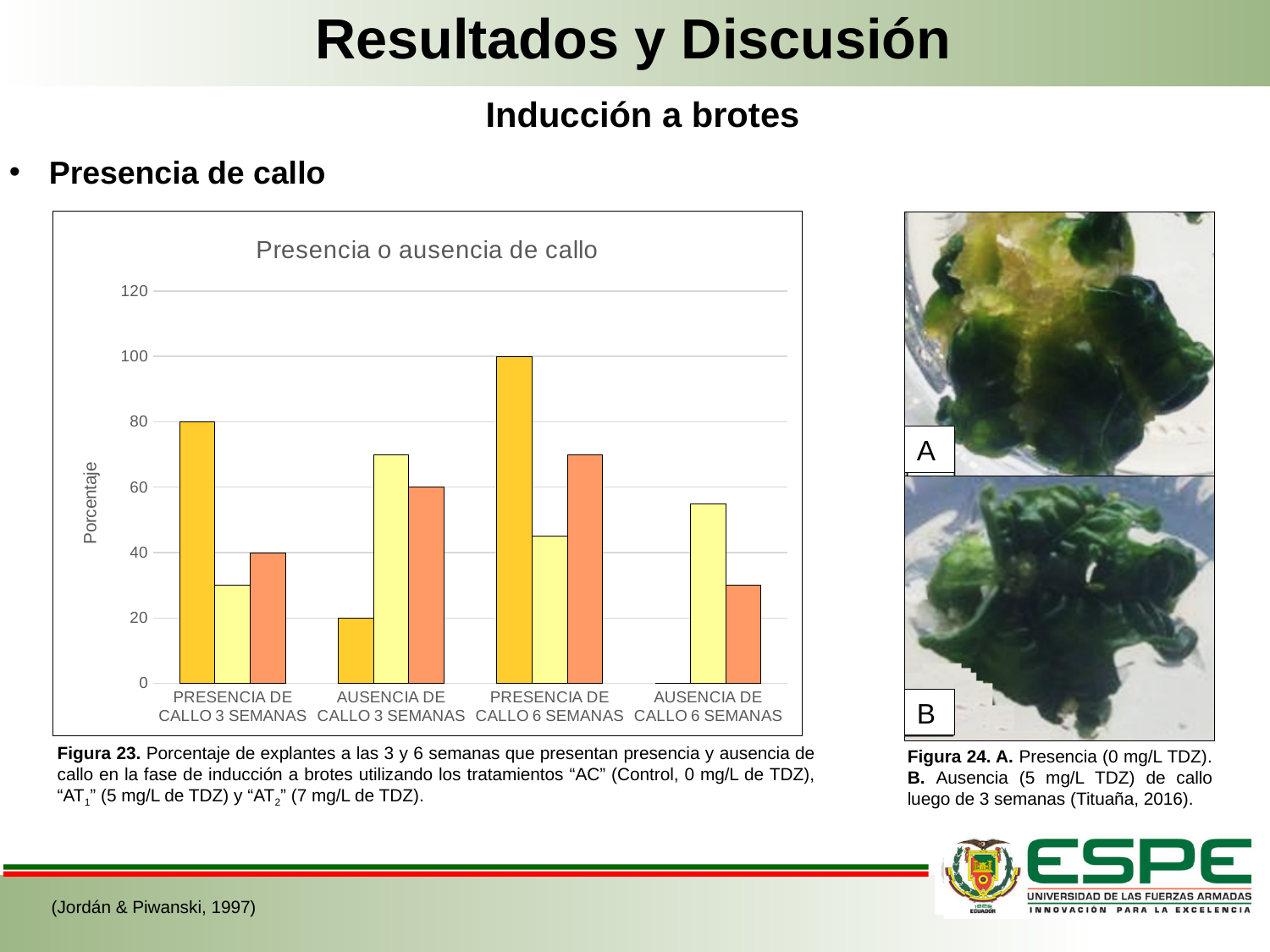
In the AUSENCIA DE CALLO 3 SEMANAS category, which is taller: the yellow bar or the dark orange bar? The yellow bar Which category contains the tallest bar in the chart? PRESENCIA DE CALLO 6 SEMANAS How many categories are shown along the x axis of the chart? 4 What is the value of the dark orange bar for PRESENCIA DE CALLO 6 SEMANAS? 100 What is the value of the dark orange bar for AUSENCIA DE CALLO 3 SEMANAS? 20 Is the value of the yellow bar for AUSENCIA DE CALLO 6 SEMANAS greater or less than 40? greater What is the value of the dark orange bar for PRESENCIA DE CALLO 3 SEMANAS? 80 What is the difference between the dark orange bars for PRESENCIA DE CALLO 6 SEMANAS and PRESENCIA DE CALLO 3 SEMANAS? 20 What is the label of the vertical axis of the chart? Porcentaje What is the title of the chart? Presencia o ausencia de callo What type of chart is shown on the slide? Bar chart What is the value of the salmon (light orange) bar for AUSENCIA DE CALLO 3 SEMANAS? 60